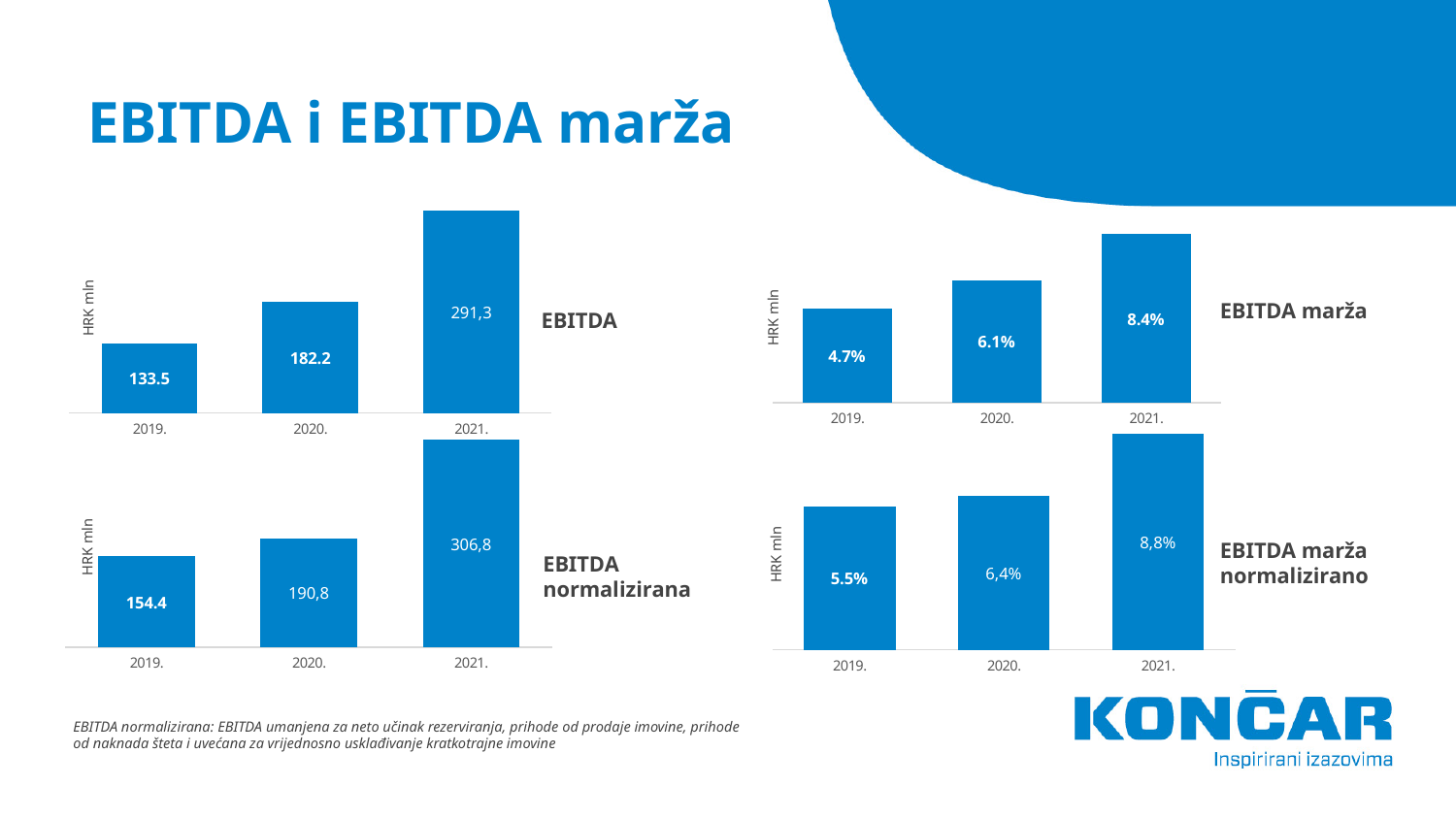
In the EBITDA chart, what is the difference between the values for 2020. and 2019.? 48.7 What kind of chart is the EBITDA marža chart? bar chart In the EBITDA marža chart, what is the difference between the values for 2021. and 2019.? 3.7% In the EBITDA marža normalizirano chart, what is the value for 2021.? 8,8% In the EBITDA normalizirana chart, what is the value for 2020.? 190,8 How many years are shown in the EBITDA normalizirana chart? 3 In the EBITDA normalizirana chart, which year has the highest value? 2021. In the EBITDA marža chart, what is the value for 2020.? 6.1% In the EBITDA marža chart, which year has the lowest value? 2019. In the EBITDA chart, what is the value for 2019.? 133.5 In the EBITDA marža normalizirano chart, which is larger, the value for 2019. or the value for 2020.? 2020. In the EBITDA chart, what is the value for 2021.? 291,3